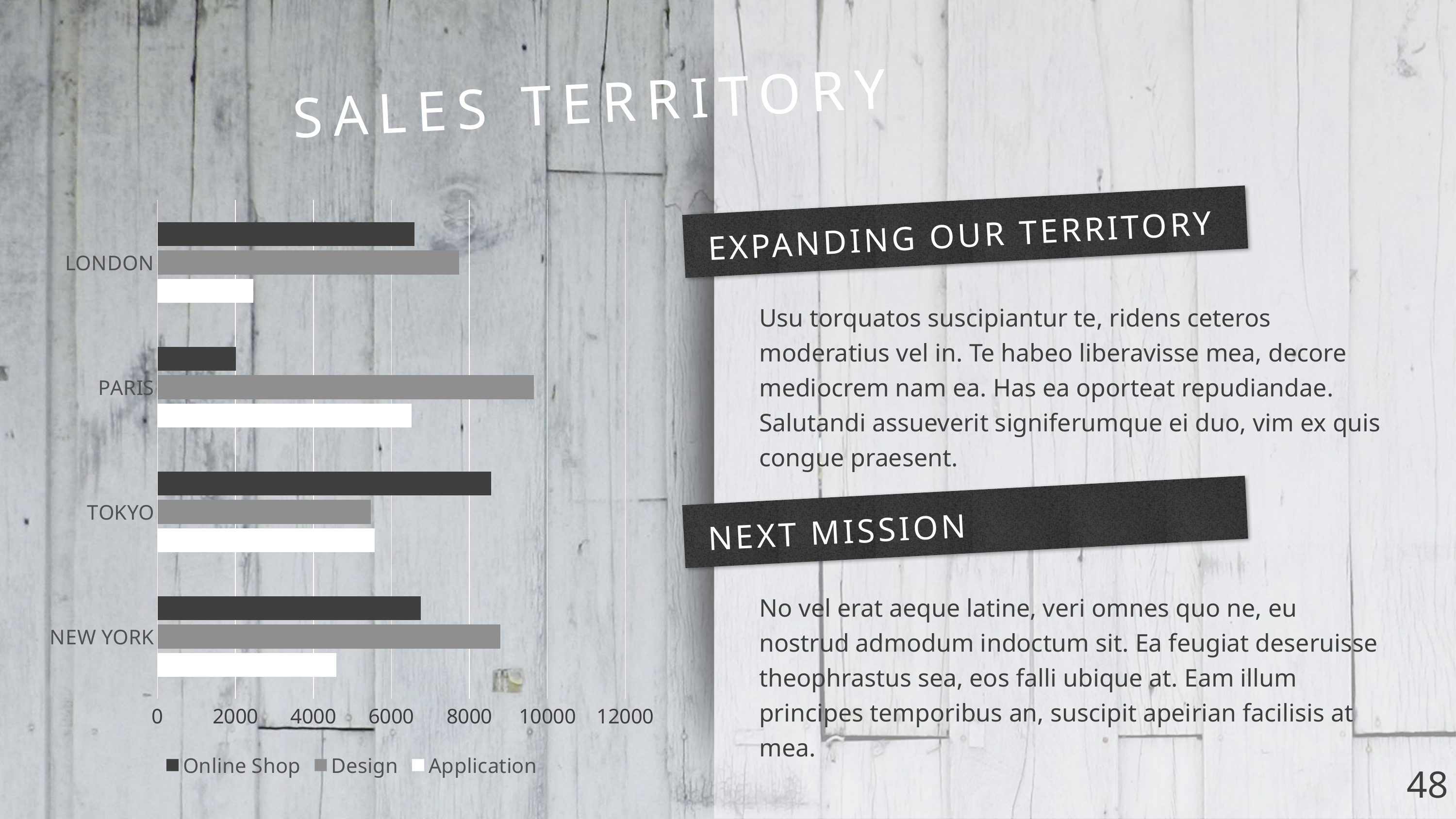
What is the title of the chart's slide? SALES TERRITORY Which city has the highest Online Shop value? TOKYO Is the Application value for LONDON greater or less than 4000? less How many series does the chart legend list? 3 What kind of chart is shown on the slide? bar chart Which city has the lowest Online Shop value? PARIS Is the Online Shop value for PARIS greater or less than 4000? less Which city has the lowest Application value? LONDON Which city has the highest Design value? PARIS Is the Design value for PARIS greater or less than 8000? greater How many cities are shown on the chart's category axis? 4 For LONDON, which is larger: the Online Shop value or the Design value? Design